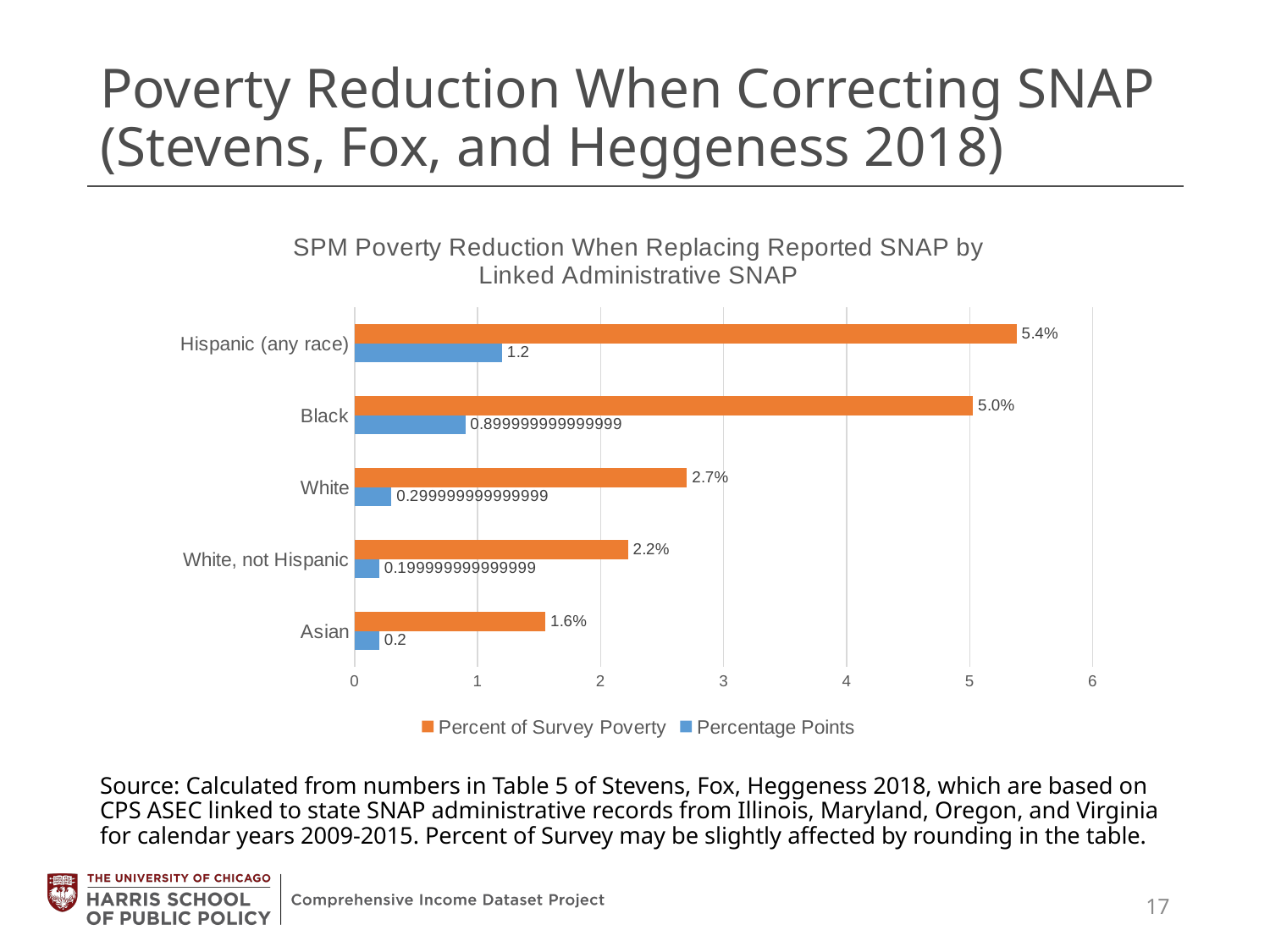
What is the Percentage Points value for Hispanic (any race)? 1.2 Which category has the lowest Percent of Survey Poverty value? Asian What is the title of the chart? SPM Poverty Reduction When Replacing Reported SNAP by Linked Administrative SNAP What is the Percent of Survey Poverty value for Asian? 1.6% What is the Percent of Survey Poverty value for Hispanic (any race)? 5.4% What type of chart is shown on the slide? Bar chart What is the Percent of Survey Poverty value for White, not Hispanic? 2.2% Which category has the highest Percent of Survey Poverty value? Hispanic (any race) How many racial/ethnic categories are shown on the chart? 5 How many series does the legend list? 2 What is the difference between the Percent of Survey Poverty values for Hispanic (any race) and White? 2.7% Which is larger, the Percent of Survey Poverty value for Black or for White? Black